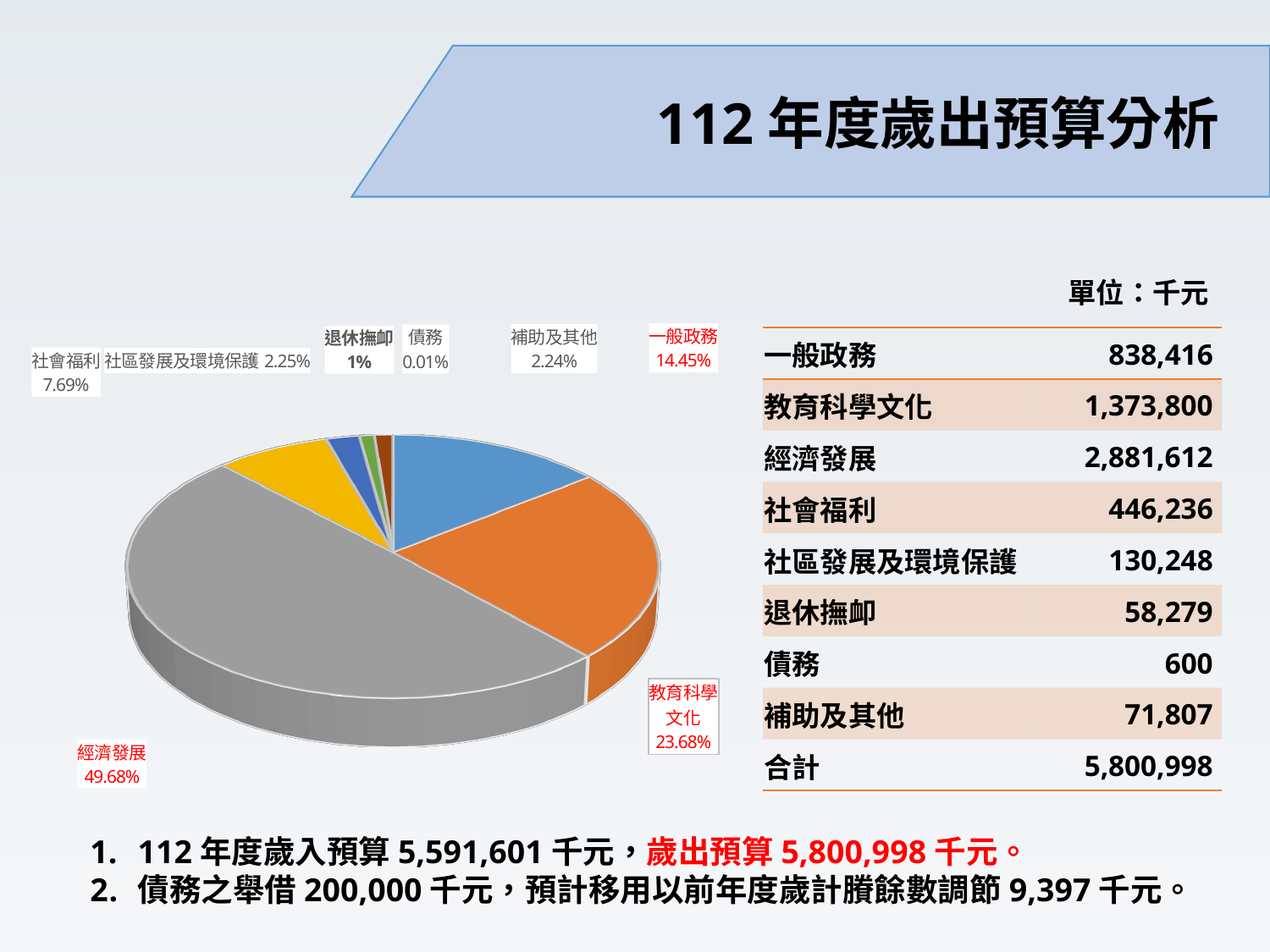
What share of the pie does 經濟發展 represent? 49.68% What is the title of the slide containing the pie chart? 112 年度歲出預算分析 How many slices does the pie chart have? 8 Which slice is larger in the pie chart, 教育科學文化 or 一般政務? 教育科學文化 What kind of chart is shown on the slide? Pie chart What percentage is shown for 債務 in the pie chart? 0.01% What is the difference in percentage points between the 經濟發展 slice and the 教育科學文化 slice? 26.00% What percentage is shown for 一般政務 in the pie chart? 14.45% What percentage is shown for 教育科學文化 in the pie chart? 23.68% Which category has the smallest slice of the pie chart? 債務 Which category has the largest slice of the pie chart? 經濟發展 What percentage is shown for 社會福利 in the pie chart? 7.69%